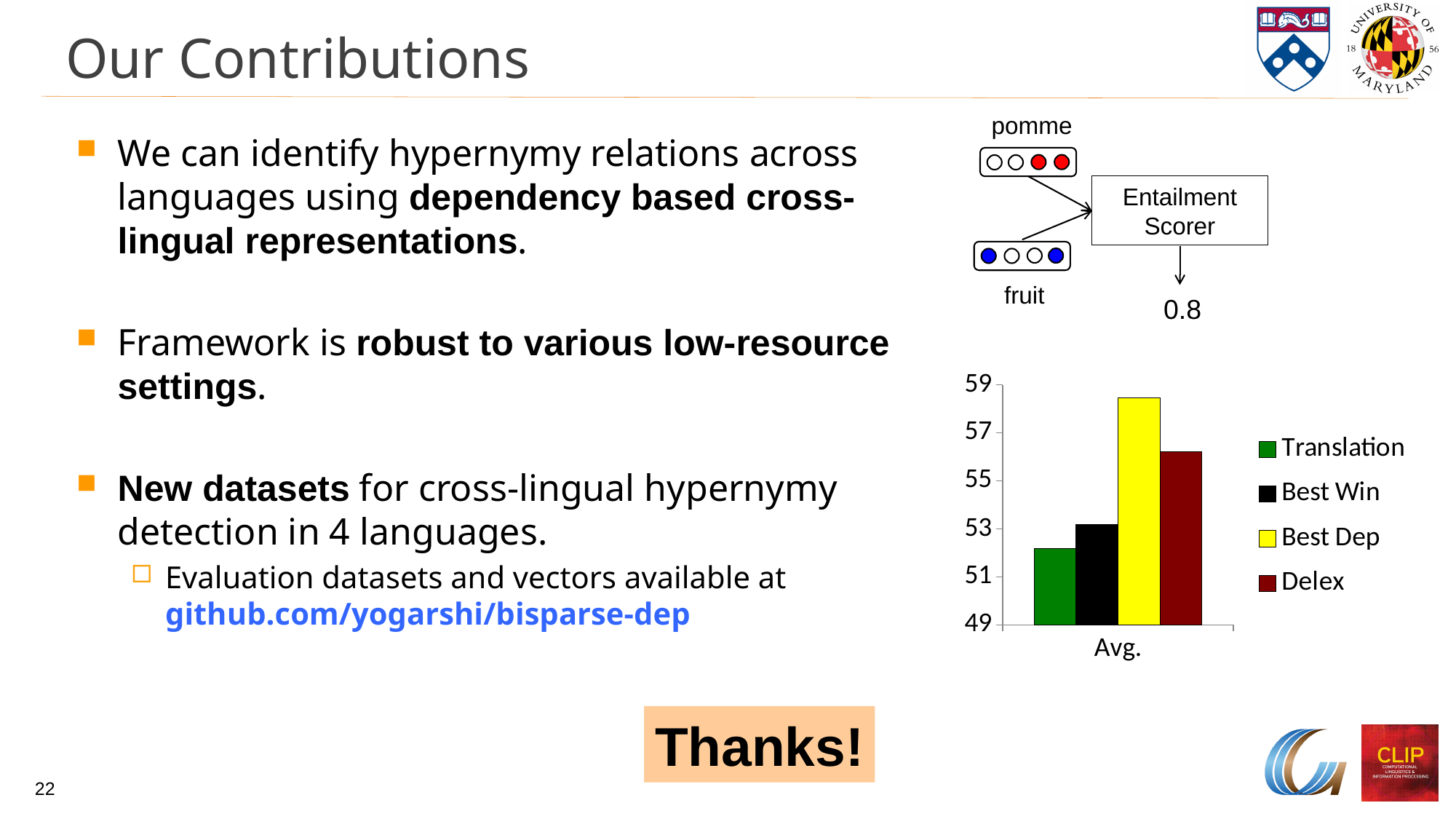
Is the value for Best Dep greater or less than 57? greater In the bar chart, which is larger, the value for Delex or the value for Best Win? Delex How many series does the legend of the bar chart list? 4 What is the label of the category on the x axis of the bar chart? Avg. Which series has the lowest bar in the bar chart? Translation Is the value for Translation greater or less than 53? less How many categories are shown on the x axis of the bar chart? 1 In the bar chart, which is larger, the value for Best Dep or the value for Delex? Best Dep Which series has the highest bar in the bar chart? Best Dep Is the value for Delex greater or less than 55? greater What kind of chart is shown on the slide? bar chart